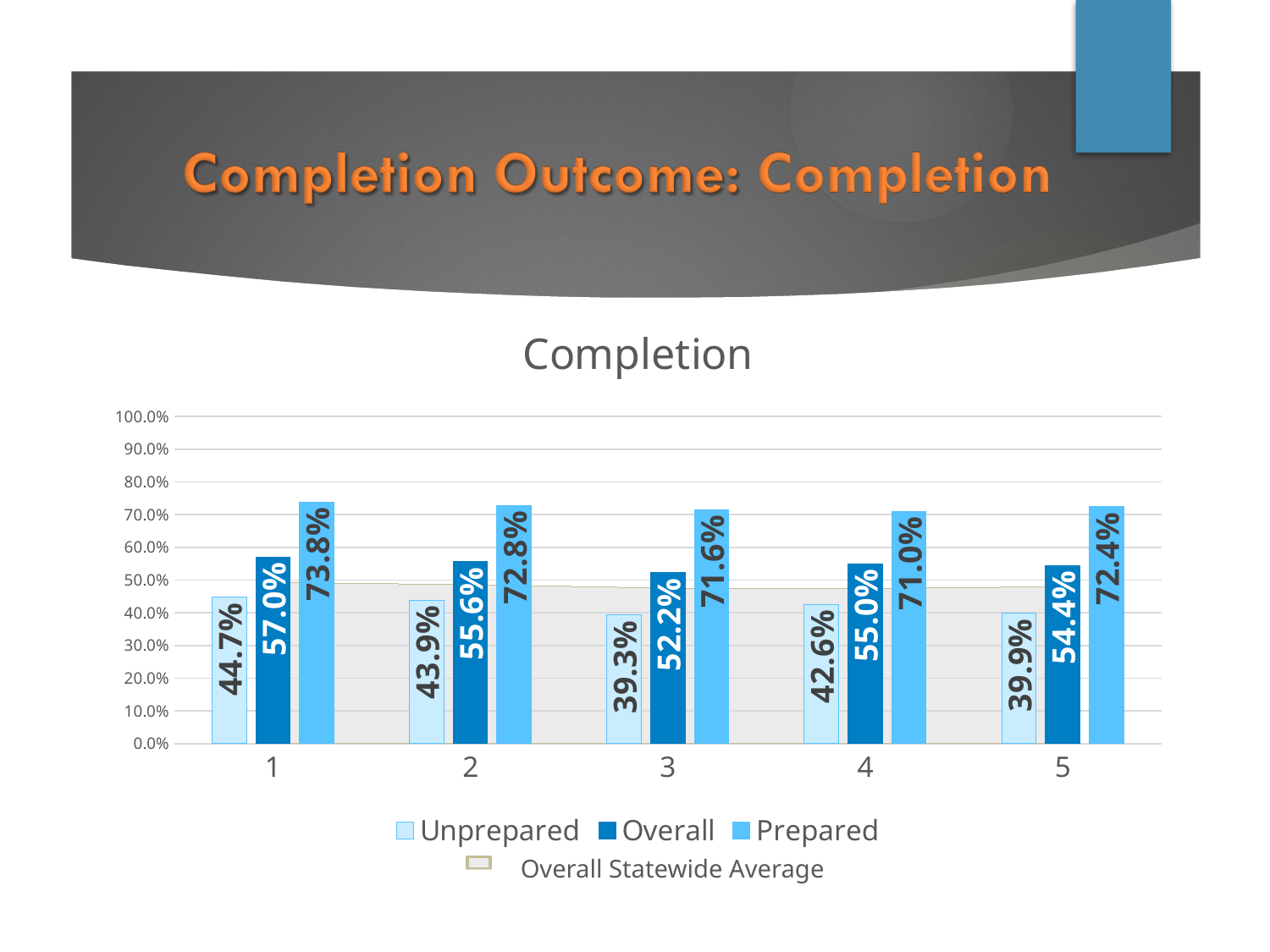
What is the Prepared completion value for category 1? 73.8% How many series does the legend list? 4 How many categories are shown on the x axis? 5 What is the title of the chart? Completion What kind of chart is used to show the Unprepared, Overall and Prepared values? bar chart What is the Overall completion value for category 5? 54.4% Which category has the lowest Unprepared completion value? 3 Which category has the highest Prepared completion value? 1 Is the Overall Statewide Average line greater or less than 60.0%? less What is the difference between the Prepared and Unprepared completion values for category 4? 28.4% Which is larger, the Overall value for category 2 or the Overall value for category 4? Overall value for category 2 What is the Unprepared completion value for category 3? 39.3%